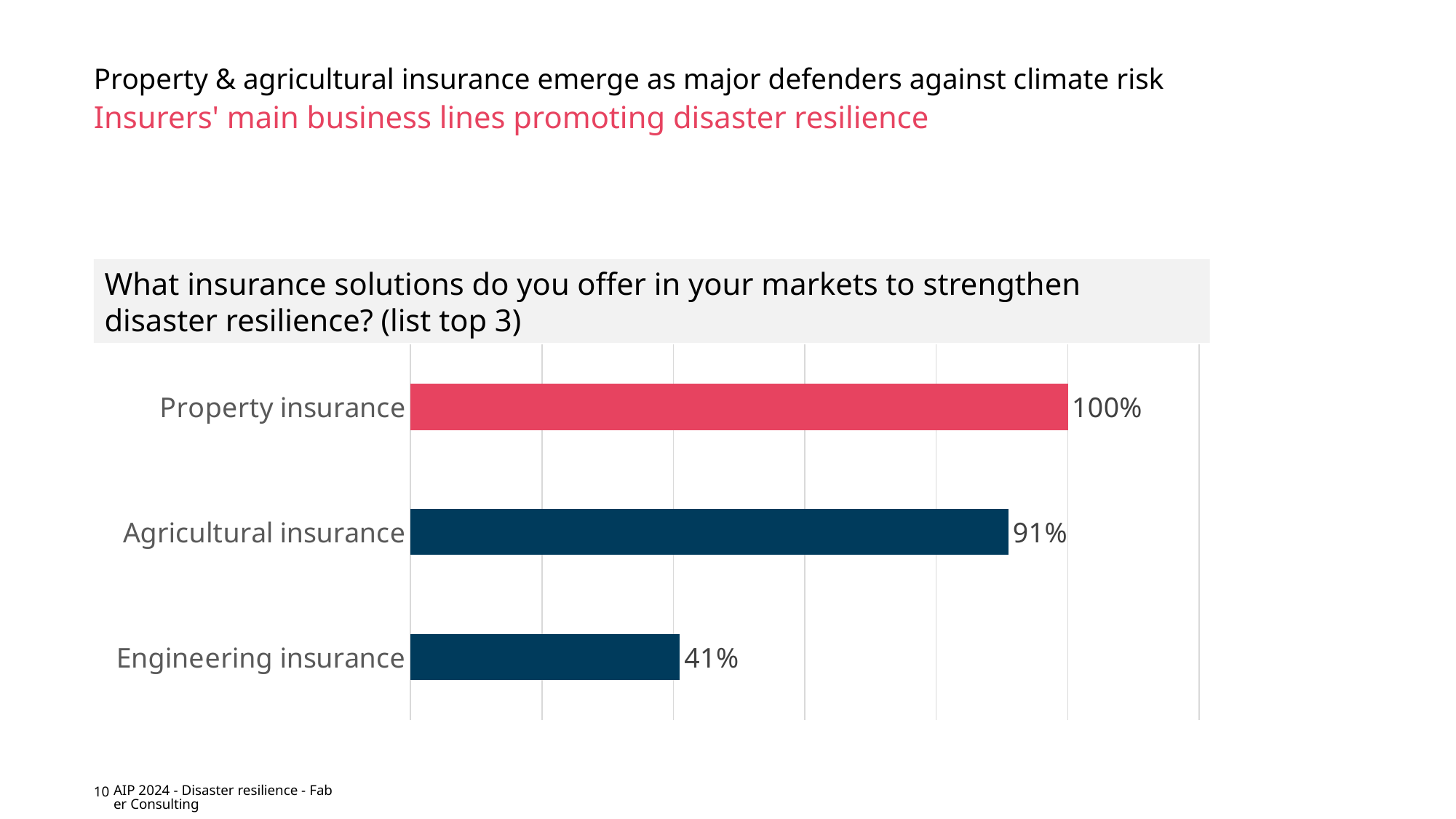
Which category's bar is coloured red rather than dark blue? Property insurance What kind of chart is shown on the slide? Bar chart What question is shown as the heading above the chart? What insurance solutions do you offer in your markets to strengthen disaster resilience? (list top 3) What is the value for Agricultural insurance? 91% What is the difference between the values for Agricultural insurance and Engineering insurance? 50% What is the value for Engineering insurance? 41% What is the difference between the values for Property insurance and Agricultural insurance? 9% Which category has the highest value? Property insurance How many categories are shown in the chart? 3 What is the value for Property insurance? 100% Which category has the lowest value? Engineering insurance Which is larger, the value for Agricultural insurance or the value for Engineering insurance? Agricultural insurance